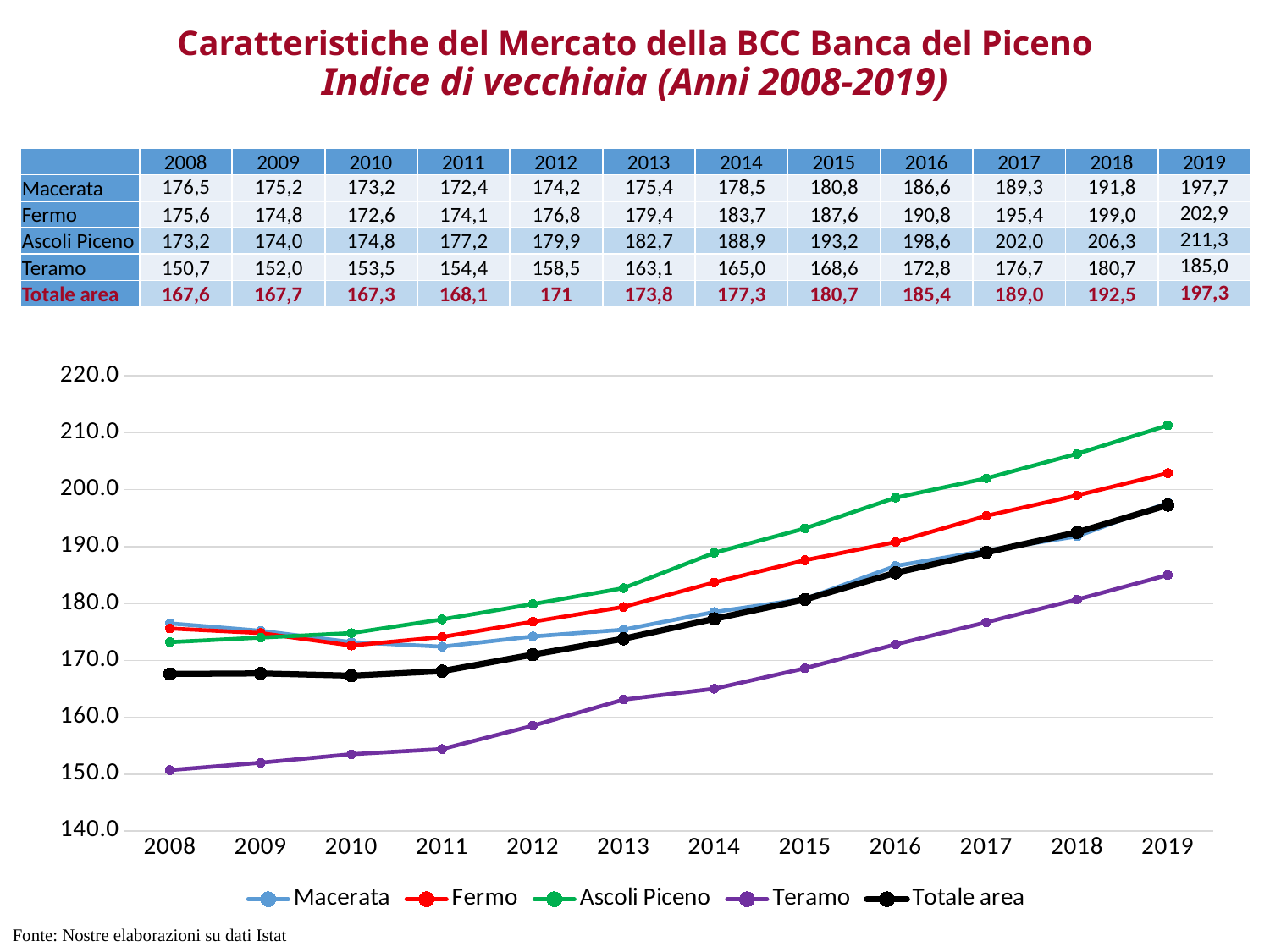
Which is larger in 2019, Fermo or Macerata? Fermo How many series does the legend list? 5 Does the Totale area series rise or fall from 2011 to 2019? rise What is the value for Ascoli Piceno in 2019? 211,3 What is the value for Totale area in 2019? 197,3 What is the difference between Ascoli Piceno and Teramo in 2019? 26,3 What is the value for Teramo in 2008? 150,7 Which series has the highest value in 2019? Ascoli Piceno Is the value for Teramo in 2008 greater or less than 160? less How many years are plotted along the x axis? 12 Which series has the lowest value in 2019? Teramo What kind of chart is shown on the slide? line chart